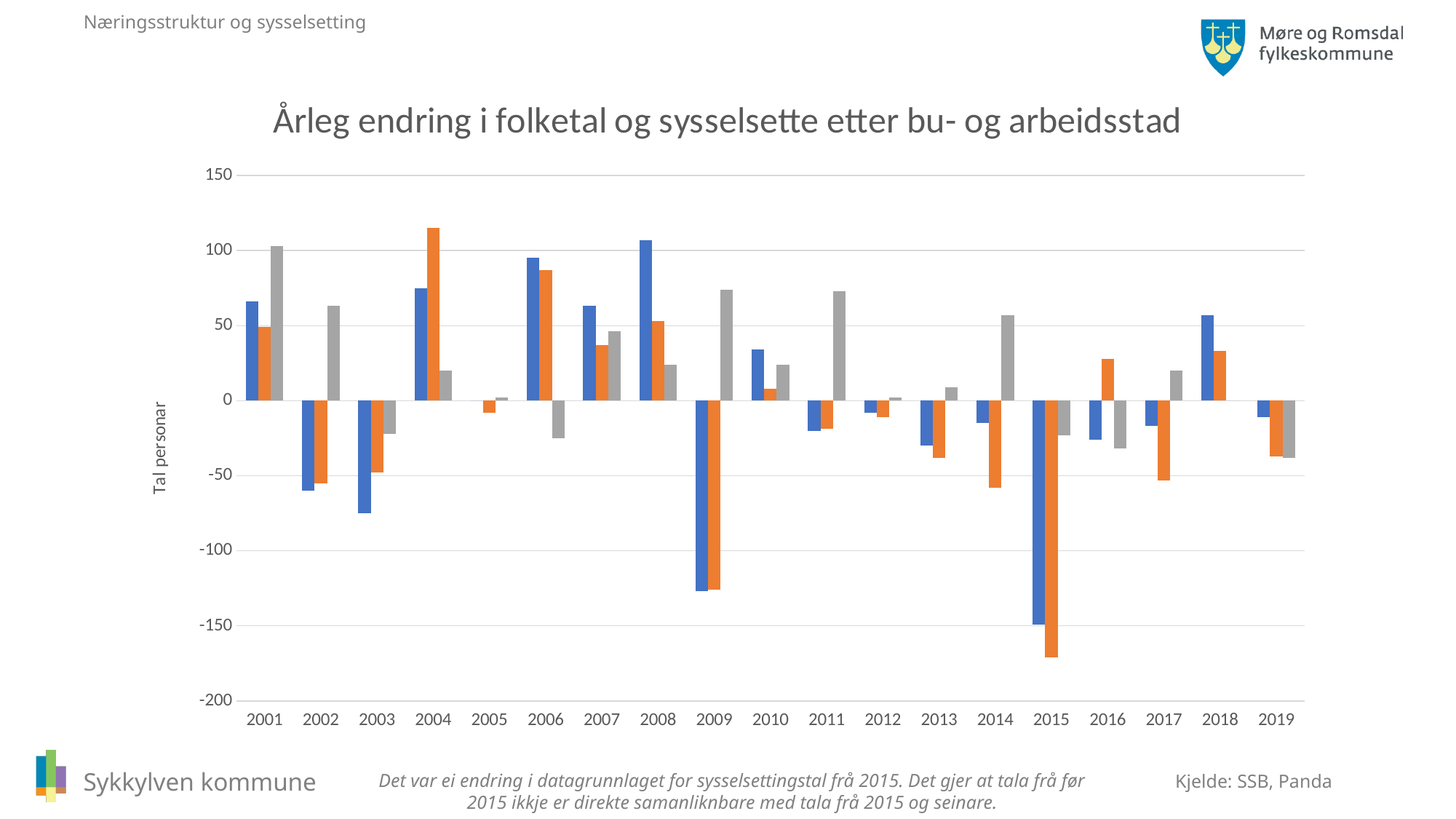
Is the value of the grey bar for 2001 greater or less than 50? greater In 2004, which bar is larger, the blue bar or the orange bar? orange How many years are shown along the x axis of the chart? 19 What kind of chart is shown on the slide? bar chart In which year is the orange bar at its lowest value? 2015 In which year is the blue bar at its lowest value? 2015 What is the label on the vertical axis of the chart? Tal personar Is the value of the orange bar for 2015 greater or less than -150? less Is the value of the blue bar for 2009 greater or less than -100? less In which year is the orange bar at its highest value? 2004 What is the title of the chart? Årleg endring i folketal og sysselsette etter bu- og arbeidsstad